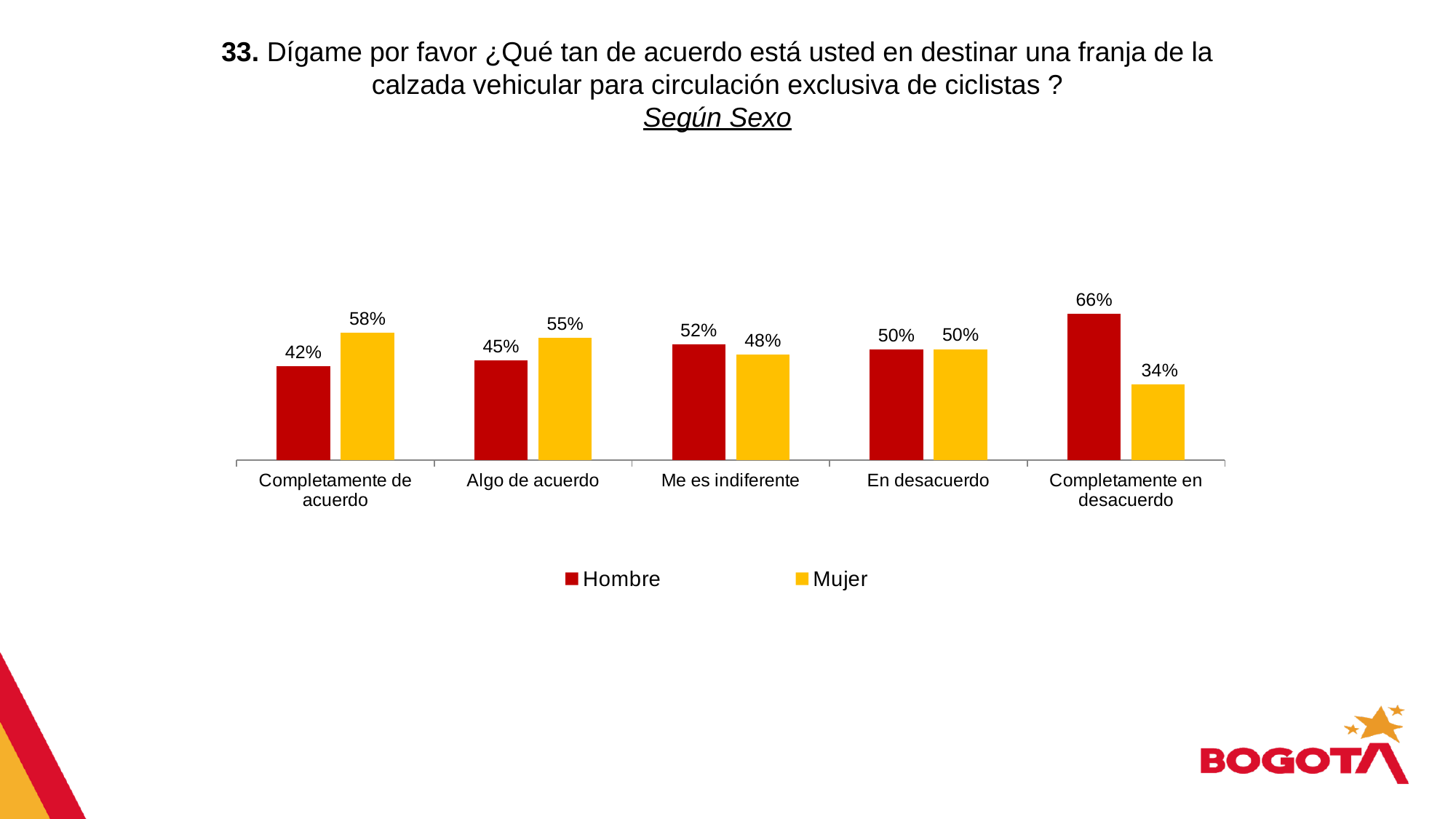
Which category has the highest value for Hombre? Completamente en desacuerdo What kind of chart is shown on the slide? Bar chart What is the value for Hombre in the 'Completamente de acuerdo' category? 42% What is the difference between the Mujer and Hombre values in the 'Completamente de acuerdo' category? 16% What is the value for Mujer in the 'Algo de acuerdo' category? 55% What is the difference between the Hombre and Mujer values in the 'Completamente en desacuerdo' category? 32% How many series does the legend list? 2 Which category has the lowest value for Mujer? Completamente en desacuerdo Which colour represents the Mujer series? Yellow How many categories are shown on the x axis? 5 What is the value for Mujer in the 'Completamente en desacuerdo' category? 34% In the 'Me es indiferente' category, which is larger, Hombre or Mujer? Hombre